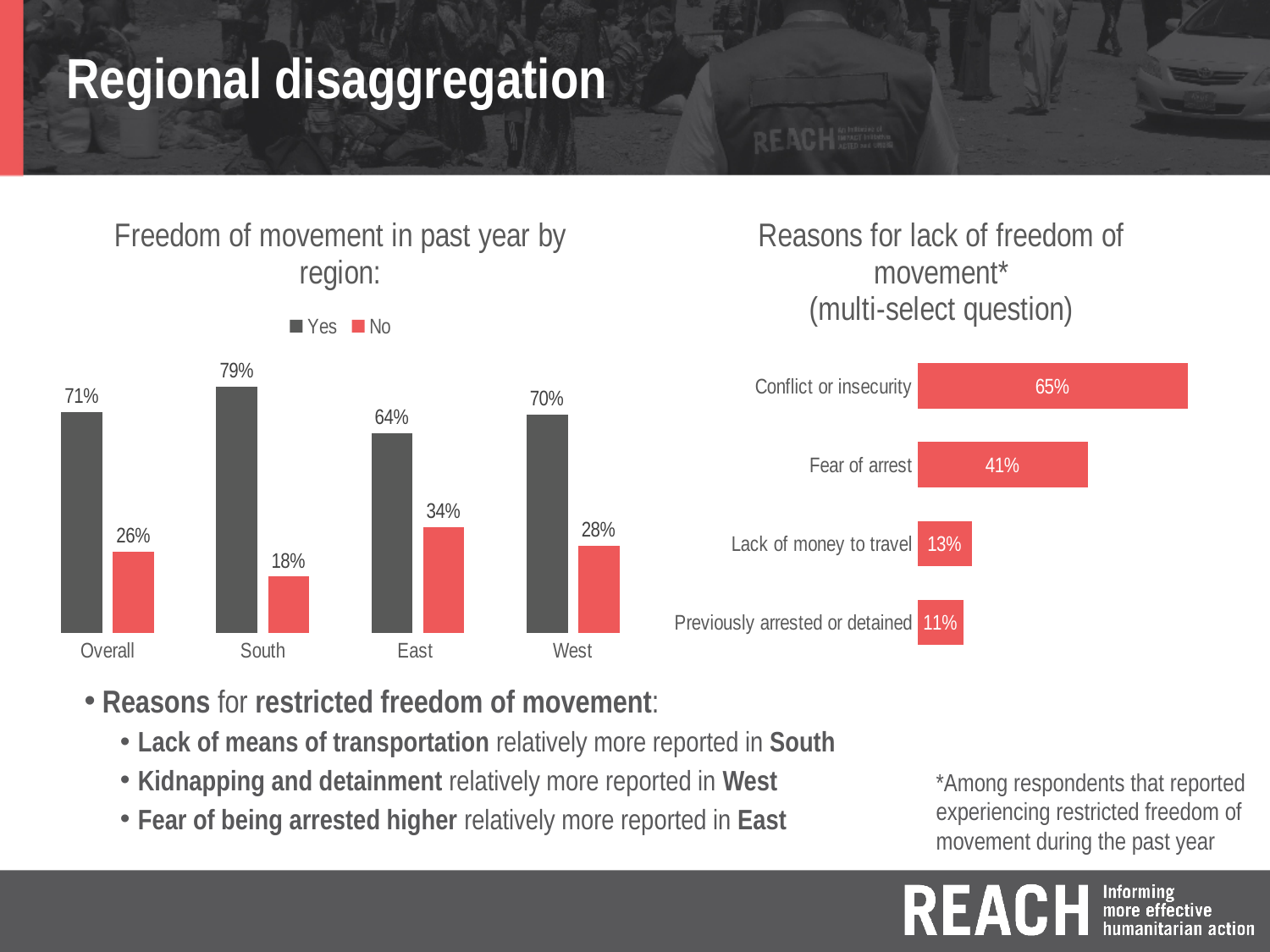
In the 'Freedom of movement in past year by region' chart, which region has the lowest 'No' value? South How many series does the legend of the 'Freedom of movement in past year by region' chart list? 2 In the 'Freedom of movement in past year by region' chart, is the 'Yes' value larger for East or for West? West In the 'Freedom of movement in past year by region' chart, which region has the highest 'Yes' value? South In the 'Reasons for lack of freedom of movement' chart, what is the value for 'Fear of arrest'? 41% In the 'Freedom of movement in past year by region' chart, what is the 'No' value for East? 34% In the 'Freedom of movement in past year by region' chart, what is the 'Yes' value for South? 79% In the 'Freedom of movement in past year by region' chart, what is the difference between the 'Yes' and 'No' values for West? 42% What kind of chart is the 'Reasons for lack of freedom of movement' chart? Bar chart In the 'Reasons for lack of freedom of movement' chart, which reason has the highest value? Conflict or insecurity In the 'Reasons for lack of freedom of movement' chart, what is the difference between 'Conflict or insecurity' and 'Lack of money to travel'? 52% How many regions are shown on the x axis of the 'Freedom of movement in past year by region' chart? 4